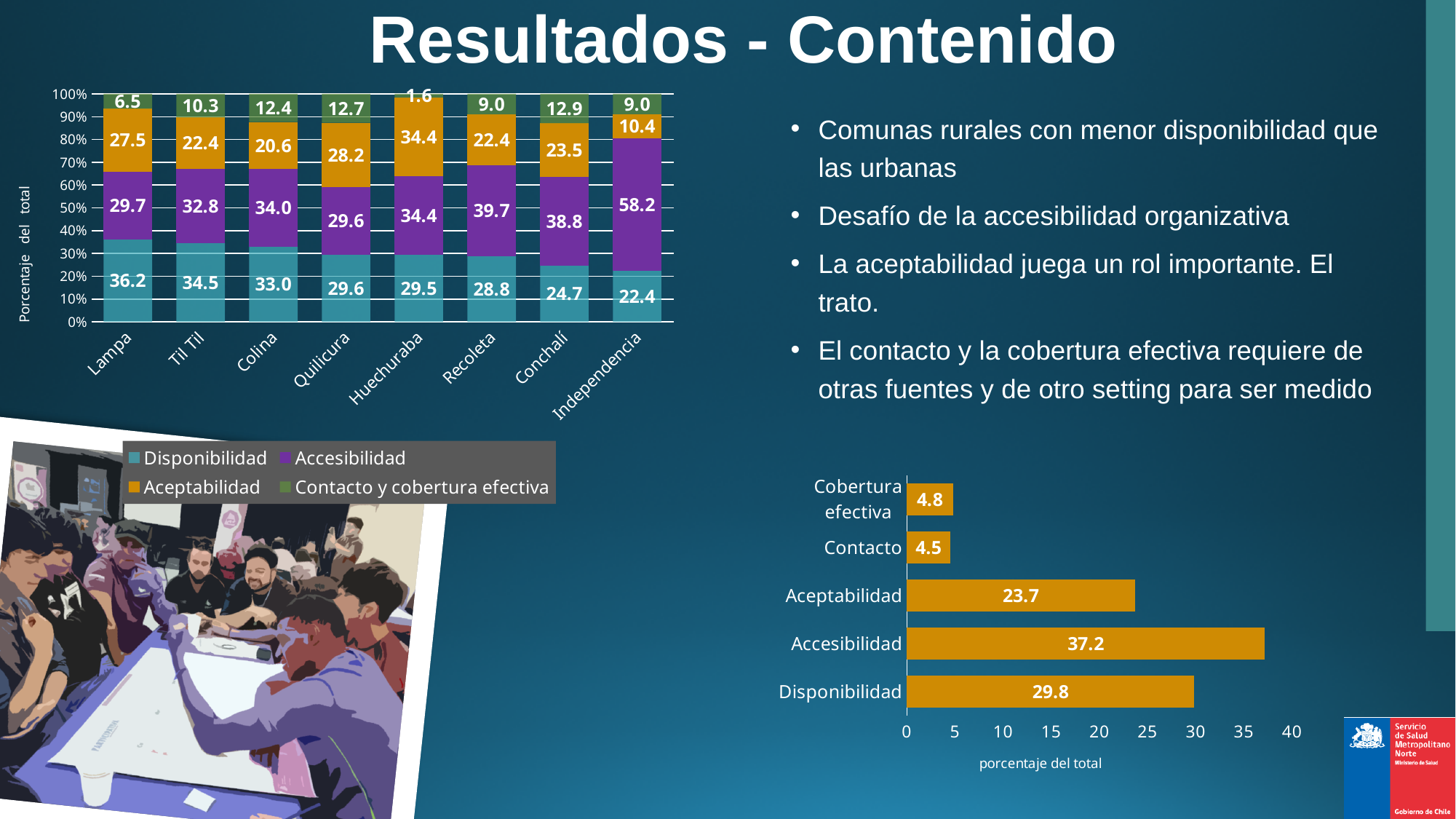
In the horizontal bar chart on the right, what is the difference between Accesibilidad and Disponibilidad? 7.4 In the stacked bar chart on the left, which comuna has the highest Disponibilidad value? Lampa In the stacked bar chart on the left, what is the Disponibilidad value for Lampa? 36.2 In the stacked bar chart on the left, what is the Aceptabilidad value for Huechuraba? 34.4 What kind of chart is shown on the right side of the slide? Bar chart In the stacked bar chart on the left, which comuna has the lowest Contacto y cobertura efectiva value? Huechuraba In the stacked bar chart on the left, how many series does the legend list? 4 In the stacked bar chart on the left, how many comunas are shown on the x axis? 8 In the stacked bar chart on the left, what is the Accesibilidad value for Independencia? 58.2 In the horizontal bar chart on the right, which category has the lowest value? Contacto In the horizontal bar chart on the right, what is the value for Accesibilidad? 37.2 In the stacked bar chart on the left, what is the difference between the Accesibilidad values for Recoleta and Quilicura? 10.1